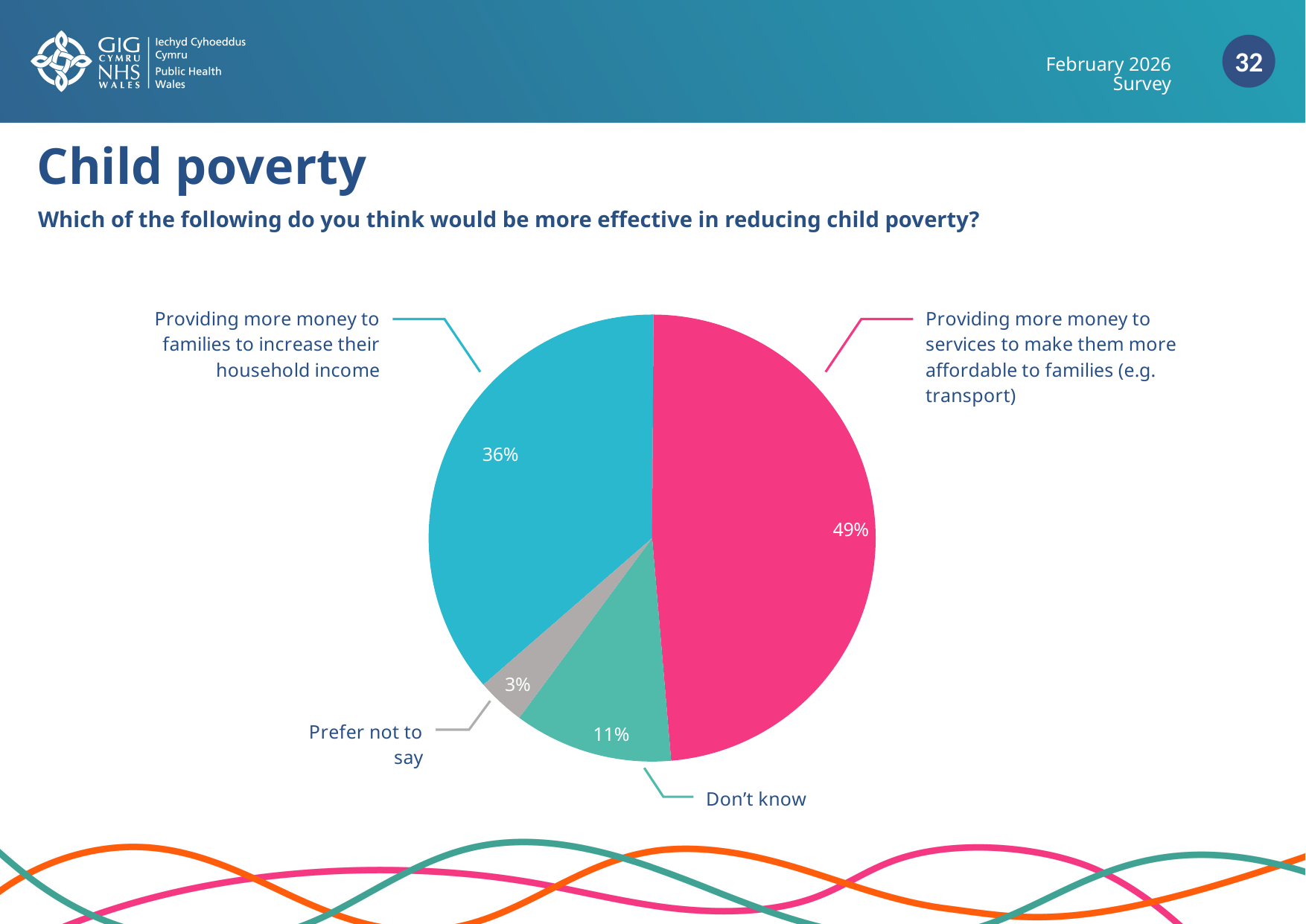
What is the difference in percentage points between 'Providing more money to services' and 'Providing more money to families'? 13 percentage points Which response has the largest share of the pie? Providing more money to services to make them more affordable to families (e.g. transport) What percentage of respondents chose 'Providing more money to families to increase their household income'? 36% What percentage of respondents answered 'Don't know'? 11% What percentage of respondents chose 'Prefer not to say'? 3% Which response has the smallest share of the pie? Prefer not to say What colour is the slice for 'Don't know'? Green What question does the chart present responses to? Which of the following do you think would be more effective in reducing child poverty? Which is larger: the share for 'Don't know' or the share for 'Prefer not to say'? Don't know What kind of chart is shown on the slide? Pie chart How many slices does the pie chart have? 4 What percentage of respondents chose 'Providing more money to services to make them more affordable to families (e.g. transport)'? 49%